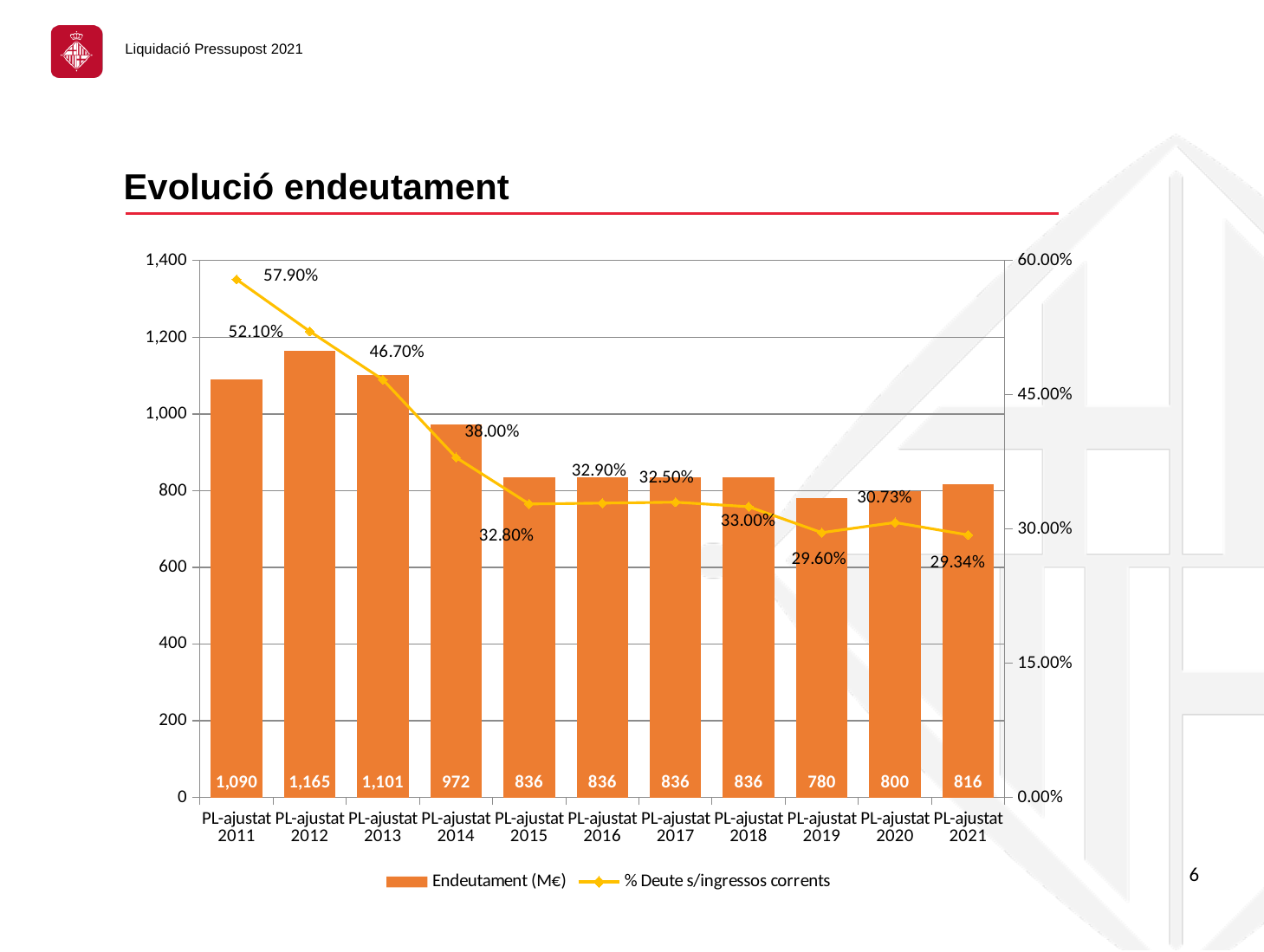
Which category has the lowest Endeutament (M€) value? PL-ajustat 2019 What is the % Deute s/ingressos corrents value for PL-ajustat 2020? 30.73% What is the title of the chart? Evolució endeutament Which category has the highest Endeutament (M€) value? PL-ajustat 2012 Which is larger, the Endeutament (M€) value for PL-ajustat 2014 or for PL-ajustat 2020? PL-ajustat 2014 What is the % Deute s/ingressos corrents value for PL-ajustat 2011? 57.90% What is the Endeutament (M€) value for PL-ajustat 2021? 816 Which category has the lowest % Deute s/ingressos corrents value? PL-ajustat 2021 How many categories are shown on the x axis? 11 What is the Endeutament (M€) value for PL-ajustat 2012? 1,165 What is the difference in Endeutament (M€) between PL-ajustat 2012 and PL-ajustat 2011? 75 How many series does the legend list? 2